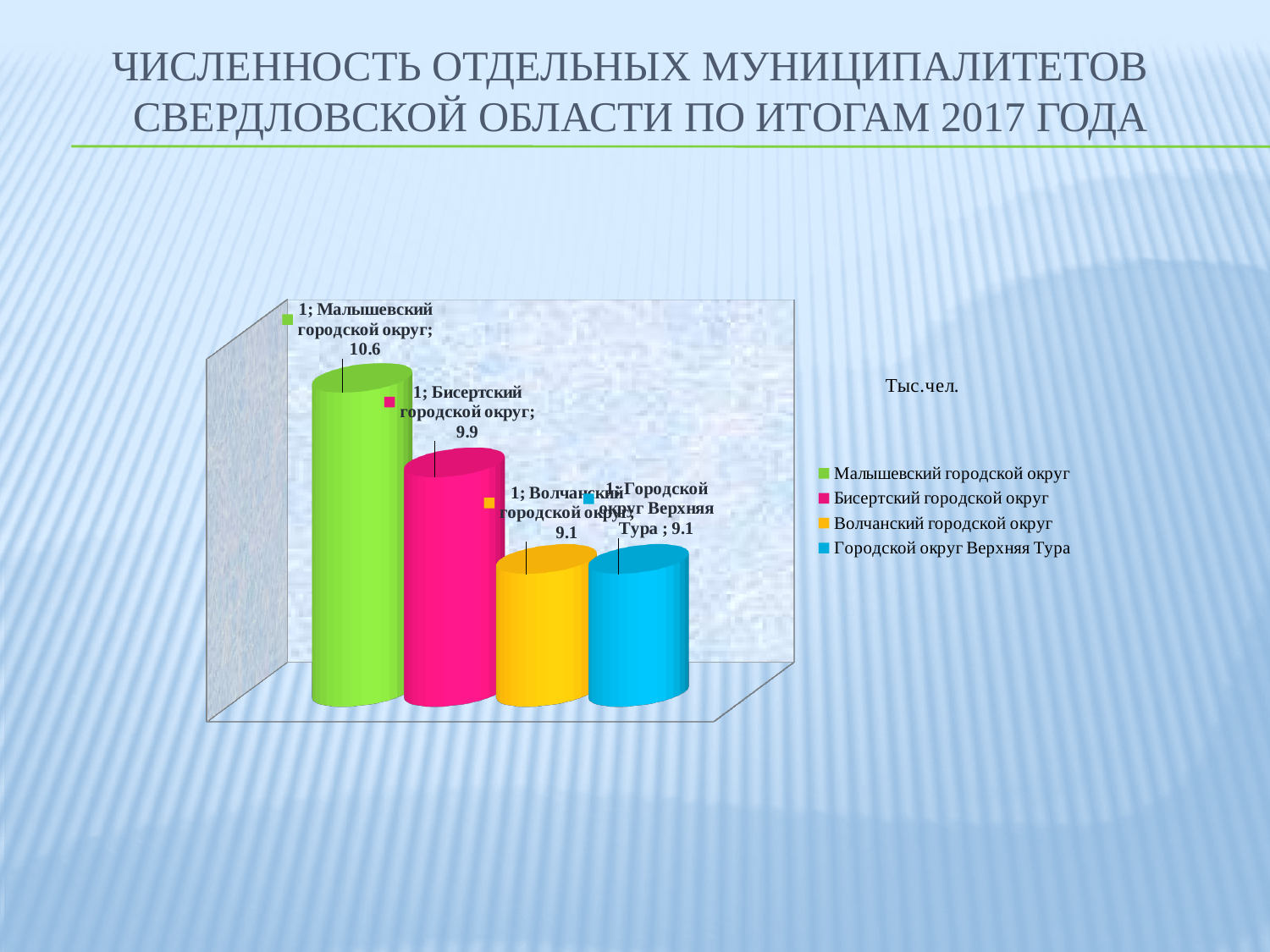
How many bars are plotted in the chart? 4 What unit is indicated next to the chart? Тыс.чел. What kind of chart is shown on the slide? Bar chart How many entries does the legend list? 4 What is the value for Волчанский городской округ? 9.1 What is the value for Малышевский городской округ? 10.6 What is the difference between the values for Малышевский городской округ and Бисертский городской округ? 0.7 Which is larger, the value for Малышевский городской округ or Бисертский городской округ? Малышевский городской округ What is the value for Бисертский городской округ? 9.9 What is the value for Городской округ Верхняя Тура? 9.1 What is the difference between the values for Бисертский городской округ and Волчанский городской округ? 0.8 Which municipality has the highest value? Малышевский городской округ